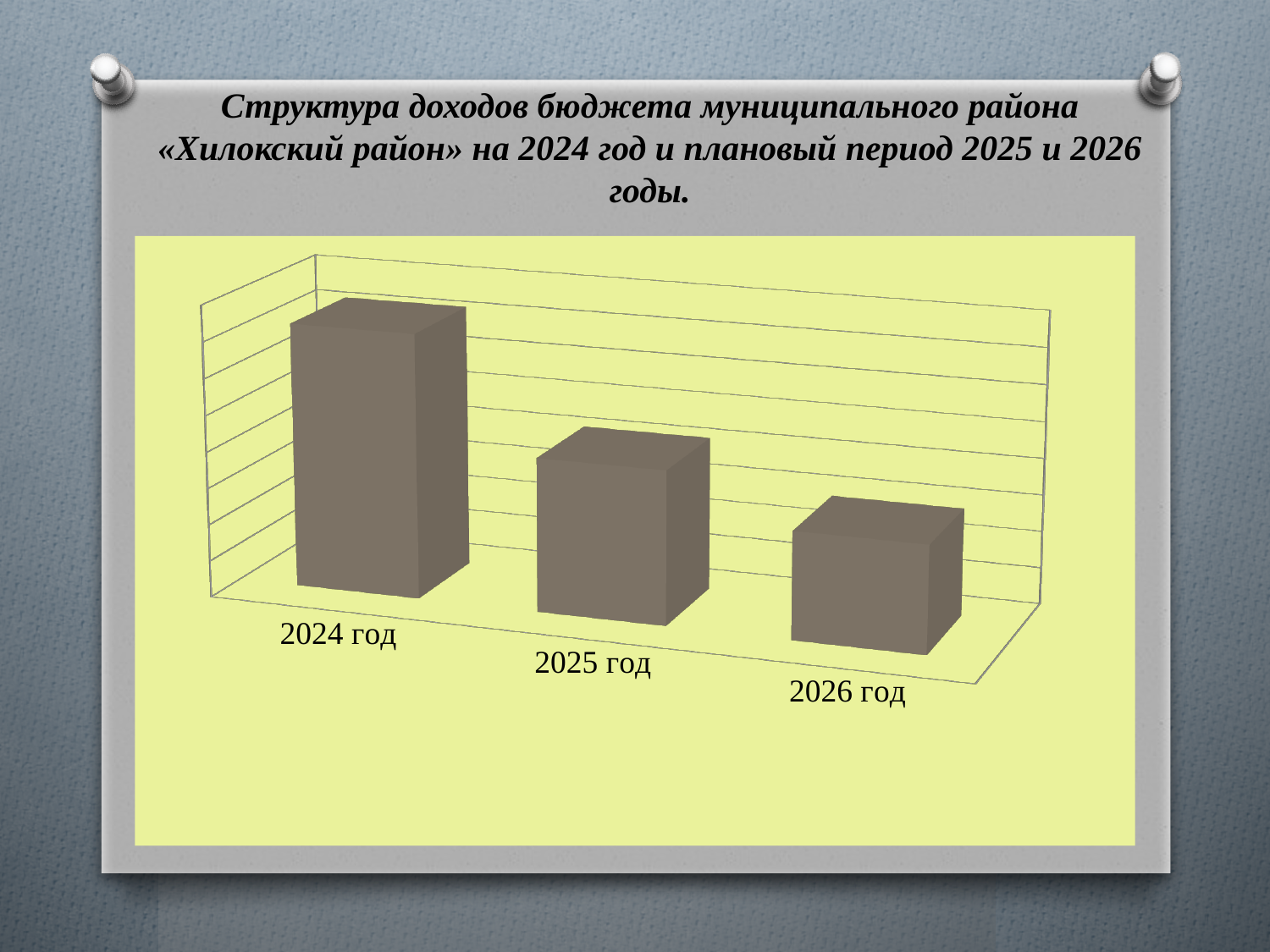
Which is larger, the bar for 2024 год or the bar for 2026 год? 2024 год Which category has the highest bar? 2024 год Which is larger, the bar for 2024 год or the bar for 2025 год? 2024 год Which is larger, the bar for 2025 год or the bar for 2026 год? 2025 год What is the label of the first category on the x axis? 2024 год Which category has the lowest bar? 2026 год How many bars (categories) does the chart show? 3 Do the bar values rise or fall from 2024 год to 2026 год? fall What kind of chart is shown on the slide? bar chart What is the label of the last category on the x axis? 2026 год